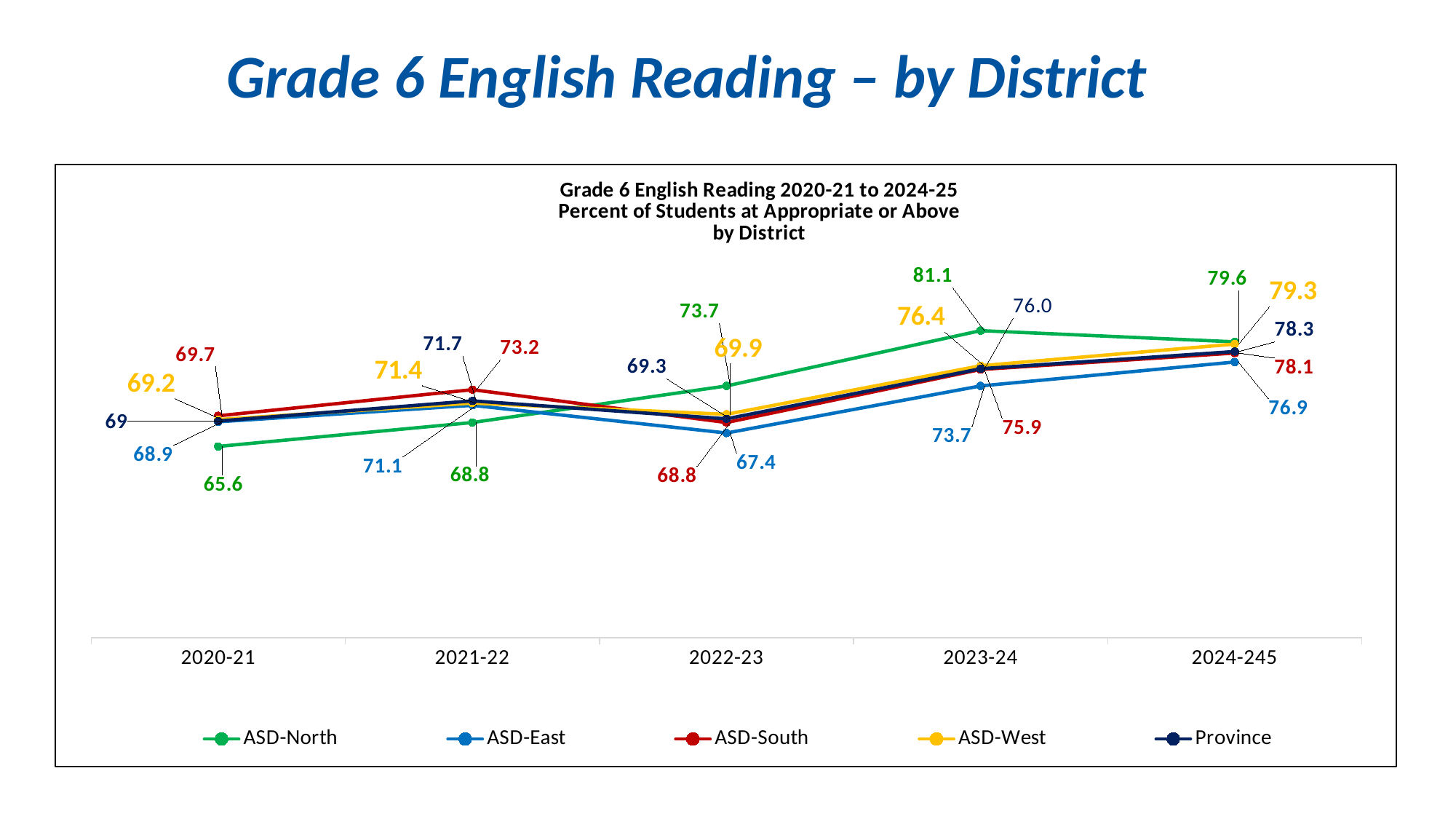
What is the value for Province in 2021-22? 71.7 How many school years are shown on the x axis? 5 What is the value for ASD-East in 2022-23? 67.4 Which district has the highest value in 2023-24? ASD-North What is the difference between ASD-North and ASD-East in 2023-24? 7.4 Which series has the lowest value in 2020-21? ASD-North What kind of chart is shown on the slide? Line chart By how much did ASD-North's value increase from 2020-21 to 2024-245? 14.0 What is the value for ASD-West in 2024-245? 79.3 How many series does the legend list? 5 What is the value for ASD-North in 2023-24? 81.1 In 2020-21, which is larger: ASD-South or ASD-West? ASD-South